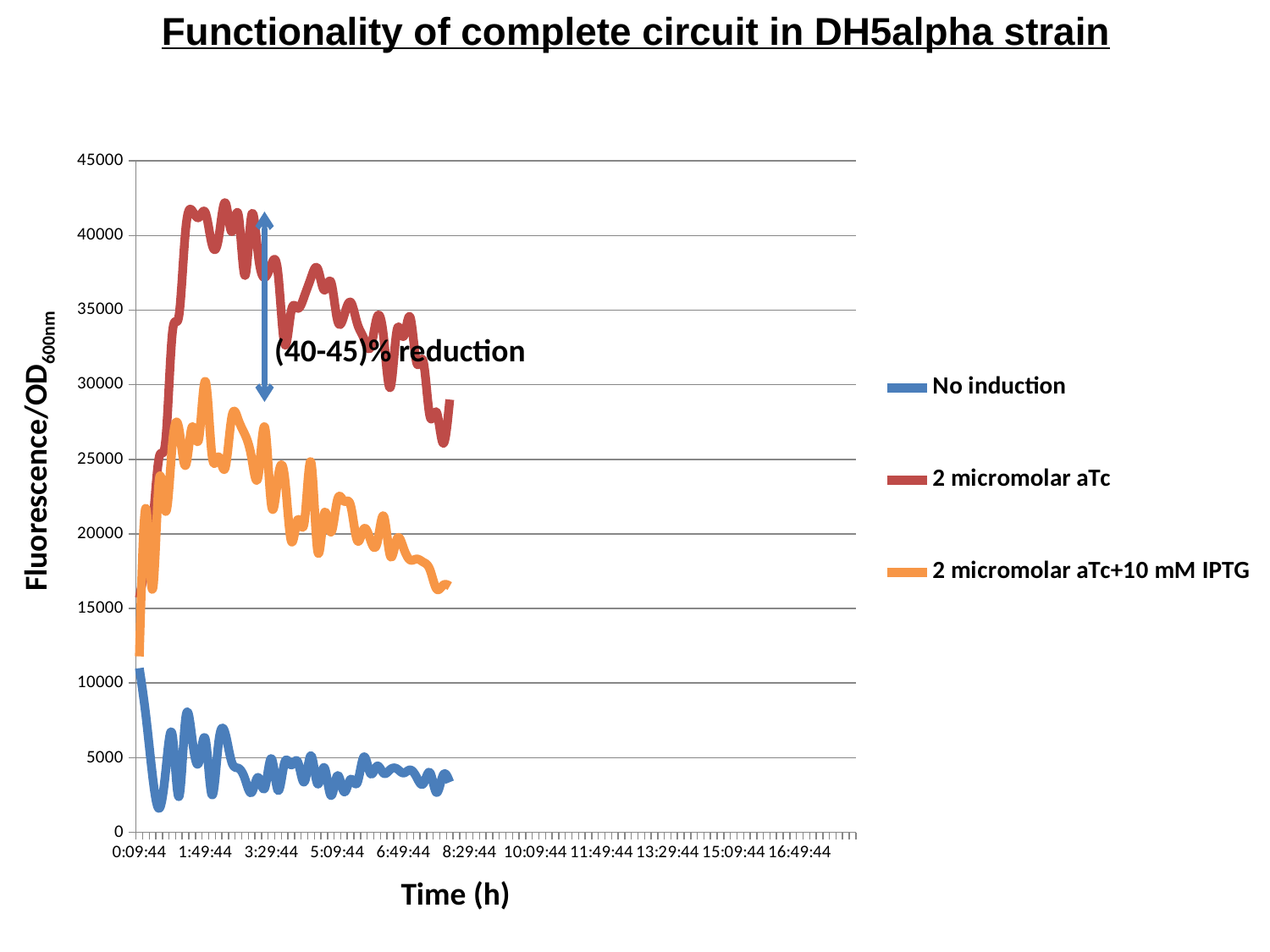
Which series is larger at 6:49:44, 2 micromolar aTc or 2 micromolar aTc+10 mM IPTG? 2 micromolar aTc Which series has the lowest fluorescence values overall? No induction After its peak, does the 2 micromolar aTc series rise or fall over time? fall What is the title of the chart? Functionality of complete circuit in DH5alpha strain Which series has the highest fluorescence values overall? 2 micromolar aTc What is the maximum value shown on the y axis? 45000 Are the values of the No induction series after 3:29:44 greater or less than 10000? less How many series does the legend list? 3 What is the label of the x axis? Time (h) Is the peak value of the 2 micromolar aTc+10 mM IPTG series greater or less than 35000? less What kind of chart is shown on the slide? line chart Is the peak value of the 2 micromolar aTc series greater or less than 40000? greater